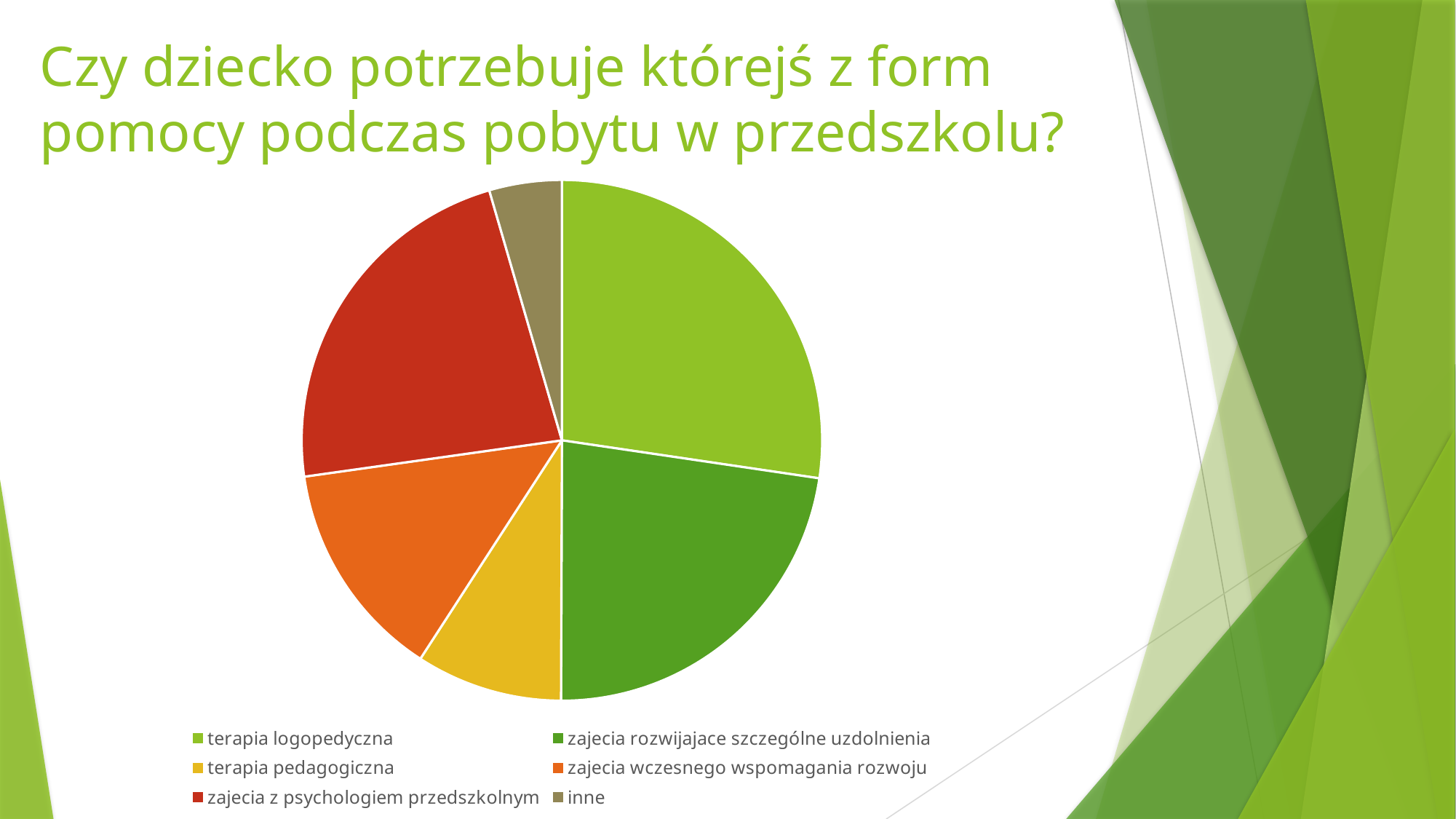
Which slice is larger: terapia pedagogiczna or zajecia wczesnego wspomagania rozwoju? zajecia wczesnego wspomagania rozwoju Which slice is larger: inne or zajecia wczesnego wspomagania rozwoju? zajecia wczesnego wspomagania rozwoju What colour is the slice for terapia pedagogiczna in the pie chart? yellow What kind of chart is shown on the slide? pie chart Which slice is larger: terapia logopedyczna or terapia pedagogiczna? terapia logopedyczna What is the title of the slide containing the pie chart? Czy dziecko potrzebuje którejś z form pomocy podczas pobytu w przedszkolu? How many entries does the legend of the pie chart list? 6 Which category has the largest slice of the pie chart? terapia logopedyczna How many slices does the pie chart have? 6 Which category has the smallest slice of the pie chart? inne